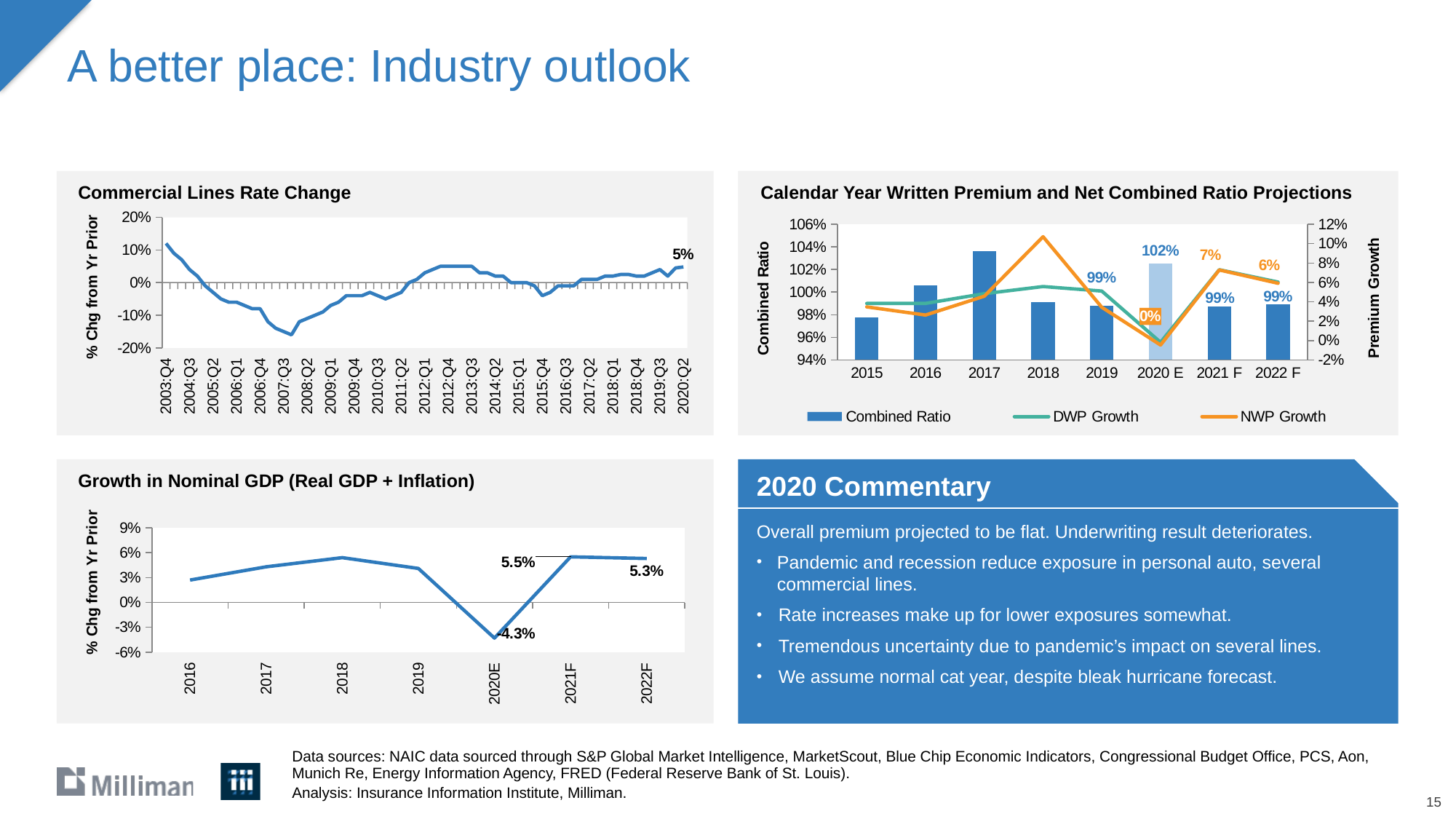
In the Calendar Year Written Premium and Net Combined Ratio Projections chart, what is the NWP Growth value labelled for 2021 F? 7% In the Calendar Year Written Premium and Net Combined Ratio Projections chart, what is the Combined Ratio for 2020 E? 102% In the Growth in Nominal GDP chart, which year has the lowest value? 2020E In the Growth in Nominal GDP chart, what is the difference between the 2021F and 2022F values? 0.2% In the Calendar Year Written Premium and Net Combined Ratio Projections chart, which year has the highest Combined Ratio bar? 2017 How many years are plotted on the x axis of the Growth in Nominal GDP chart? 7 How many series does the legend of the Calendar Year Written Premium and Net Combined Ratio Projections chart list? 3 In the Calendar Year Written Premium and Net Combined Ratio Projections chart, is the Combined Ratio for 2017 greater or less than 102%? greater In the Growth in Nominal GDP chart, what is the value for 2020E? -4.3% What kind of chart is the Growth in Nominal GDP (Real GDP + Inflation) chart? Line chart In the Commercial Lines Rate Change chart, what is the labelled value for 2020:Q2? 5% In the Calendar Year Written Premium and Net Combined Ratio Projections chart, by how much does the Combined Ratio for 2020 E exceed that for 2021 F? 3%